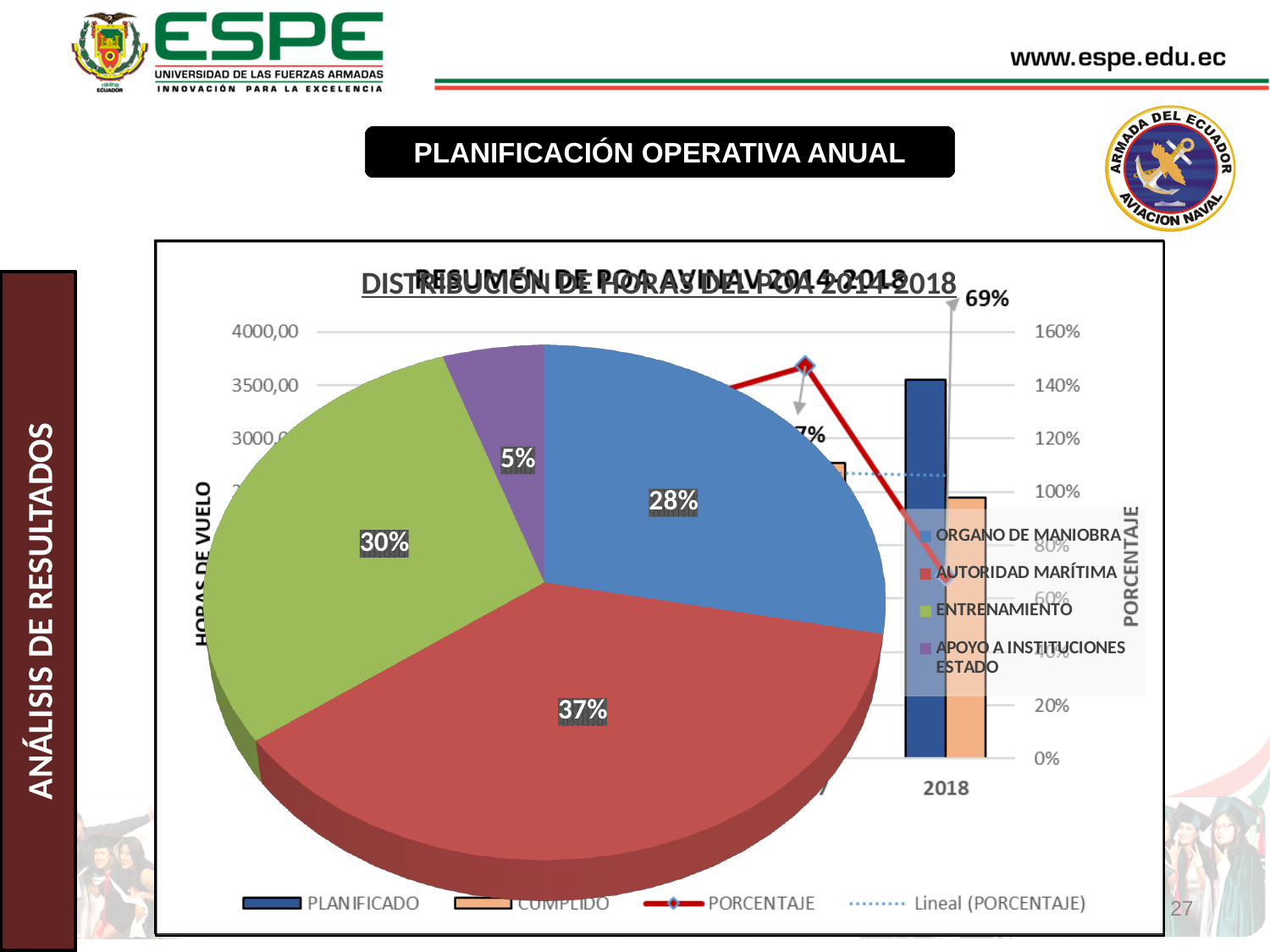
How many series does the legend at the bottom of the chart 'RESUMEN DE POA AVINAV 2014-2018' list? 4 In the pie chart 'DISTRIBUCIÓN DE HORAS DEL POA 2014-2018', which slice is larger, ENTRENAMIENTO or ORGANO DE MANIOBRA? ENTRENAMIENTO In the pie chart 'DISTRIBUCIÓN DE HORAS DEL POA 2014-2018', which category has the smallest slice? APOYO A INSTITUCIONES ESTADO In the pie chart 'DISTRIBUCIÓN DE HORAS DEL POA 2014-2018', what share is shown for ORGANO DE MANIOBRA? 28% In the chart 'RESUMEN DE POA AVINAV 2014-2018' behind the pie, what PORCENTAJE value is labelled for 2018? 69% In the pie chart 'DISTRIBUCIÓN DE HORAS DEL POA 2014-2018', what share is shown for AUTORIDAD MARÍTIMA? 37% In the pie chart 'DISTRIBUCIÓN DE HORAS DEL POA 2014-2018', what share is shown for ENTRENAMIENTO? 30% In the pie chart 'DISTRIBUCIÓN DE HORAS DEL POA 2014-2018', which category has the largest slice? AUTORIDAD MARÍTIMA In the pie chart 'DISTRIBUCIÓN DE HORAS DEL POA 2014-2018', how many percentage points larger is the AUTORIDAD MARÍTIMA slice than the ORGANO DE MANIOBRA slice? 9 percentage points What type of chart is 'DISTRIBUCIÓN DE HORAS DEL POA 2014-2018'? Pie chart How many categories does the pie chart 'DISTRIBUCIÓN DE HORAS DEL POA 2014-2018' show? 4